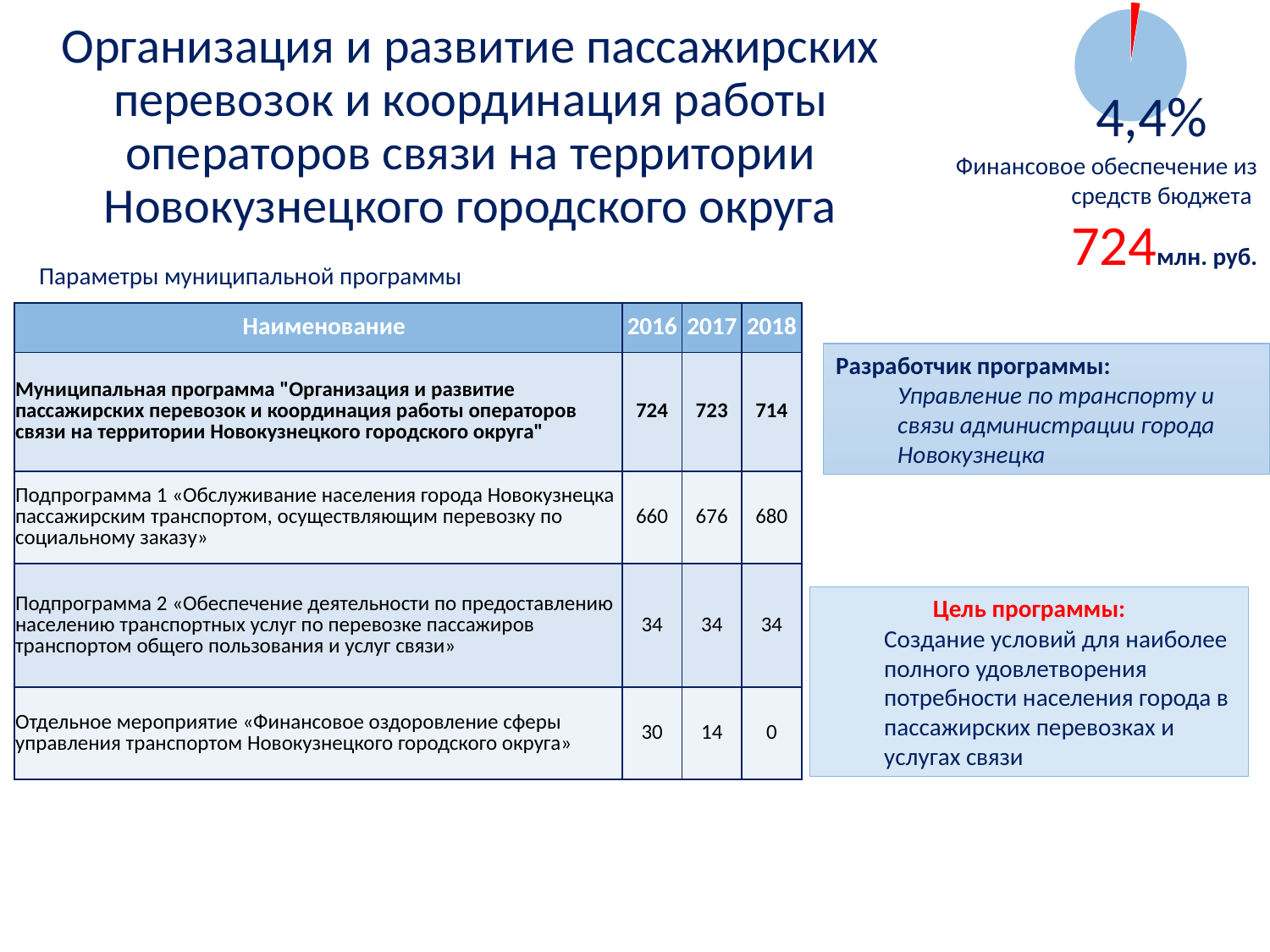
Is the share of the red slice in the pie chart greater or less than 50%? less What percentage is printed on the pie chart in the top right corner? 4,4% What caption appears directly below the pie chart in the top right corner? Финансовое обеспечение из средств бюджета What share of the pie chart does the small red slice represent? 4,4% How many slices does the pie chart in the top right corner have? 2 What kind of chart is shown in the top right corner of the slide? Pie chart Which slice of the pie chart is larger, the blue one or the red one? The blue one What colour is the small slice of the pie chart that is labelled 4,4%? Red